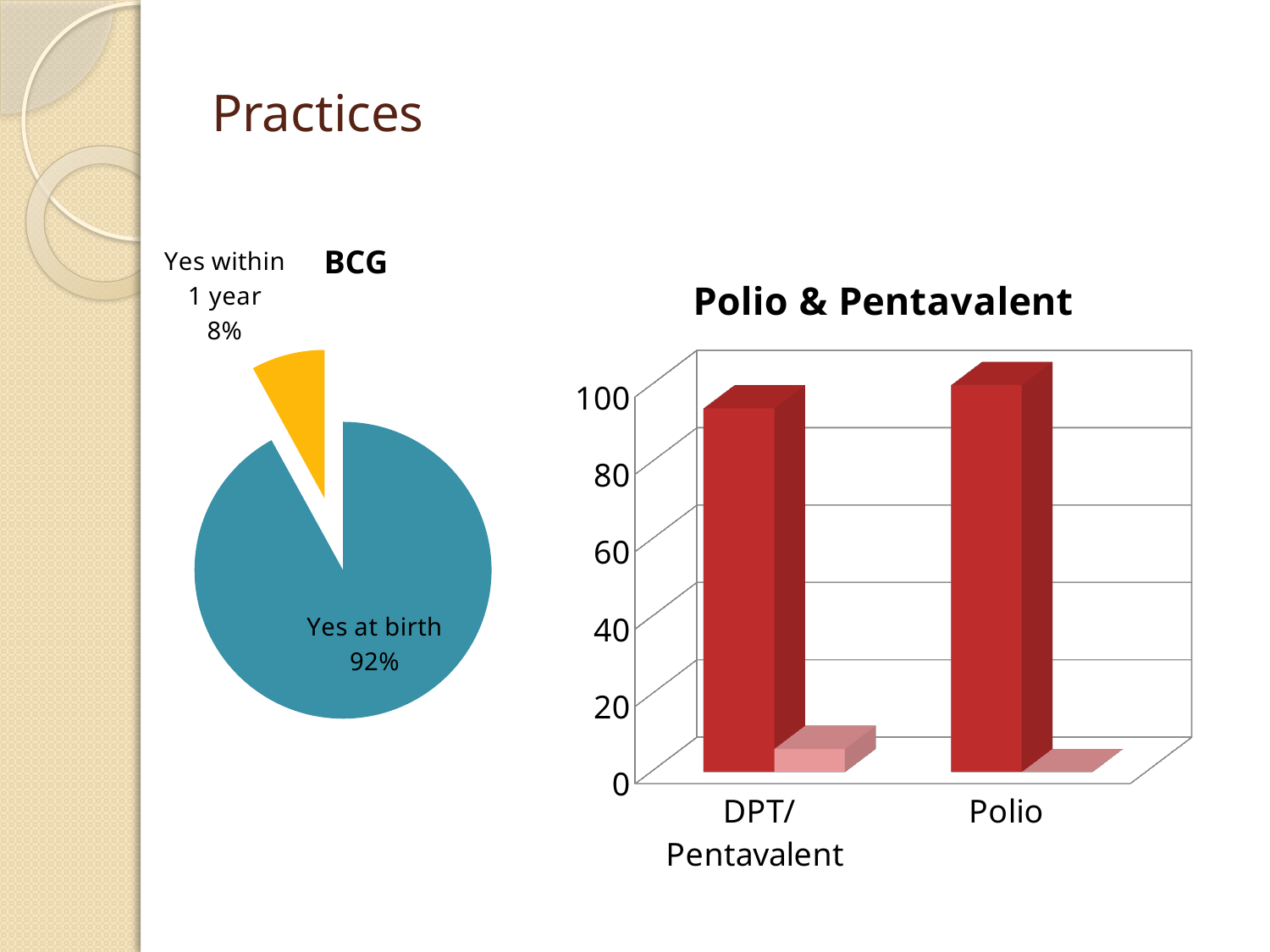
What is the title of the bar chart on the right of the slide? Polio & Pentavalent What kind of chart is the "Polio & Pentavalent" chart on the right? Bar chart In the BCG pie chart, which slice is the smallest? Yes within 1 year What kind of chart is the BCG chart on the left? Pie chart In the BCG pie chart, what is the difference in percentage points between "Yes at birth" and "Yes within 1 year"? 84 In the "Polio & Pentavalent" chart, is the value of the small pink bar for DPT/Pentavalent greater or less than 20? less How many categories are shown on the x axis of the "Polio & Pentavalent" chart? 2 In the BCG pie chart, which slice is the largest? Yes at birth In the BCG pie chart, what percentage is shown for "Yes within 1 year"? 8% In the BCG pie chart, what percentage is shown for "Yes at birth"? 92% In the "Polio & Pentavalent" chart, is the value of the tall dark red bar for DPT/Pentavalent greater or less than 80? greater How many slices does the BCG pie chart have? 2